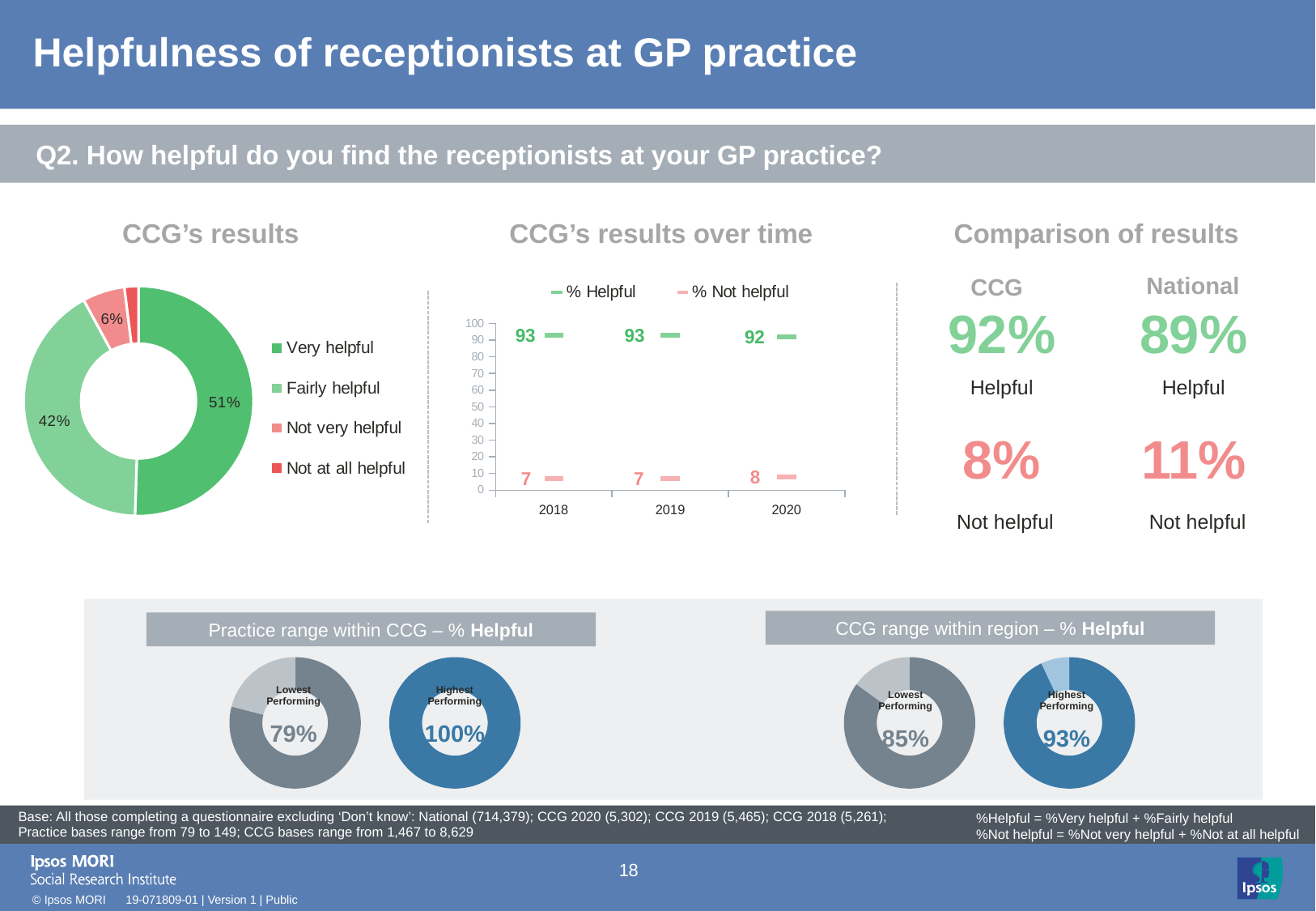
In the 'CCG's results' donut chart, which category has the largest share? Very helpful In the 'Comparison of results' section, what is the National % Helpful figure? 89% In the 'CCG's results over time' chart, how many series does the legend list? 2 In the 'CCG's results' donut chart, what percentage is shown for Not very helpful? 6% In the 'CCG's results over time' chart, what is the % Helpful value for 2020? 92 In the 'CCG's results over time' chart, how many years are shown on the x axis? 3 In the 'CCG's results over time' chart, what is the % Not helpful value for 2018? 7 In the 'CCG's results' donut chart, what percentage is shown for Fairly helpful? 42% In the 'CCG's results over time' chart, what is the difference between % Helpful and % Not helpful in 2019? 86 In the 'Practice range within CCG – % Helpful' charts, what is the Highest Performing value? 100% In the 'CCG's results' donut chart, what percentage is shown for Very helpful? 51% In the 'CCG's results' donut chart, how many categories does the legend list? 4